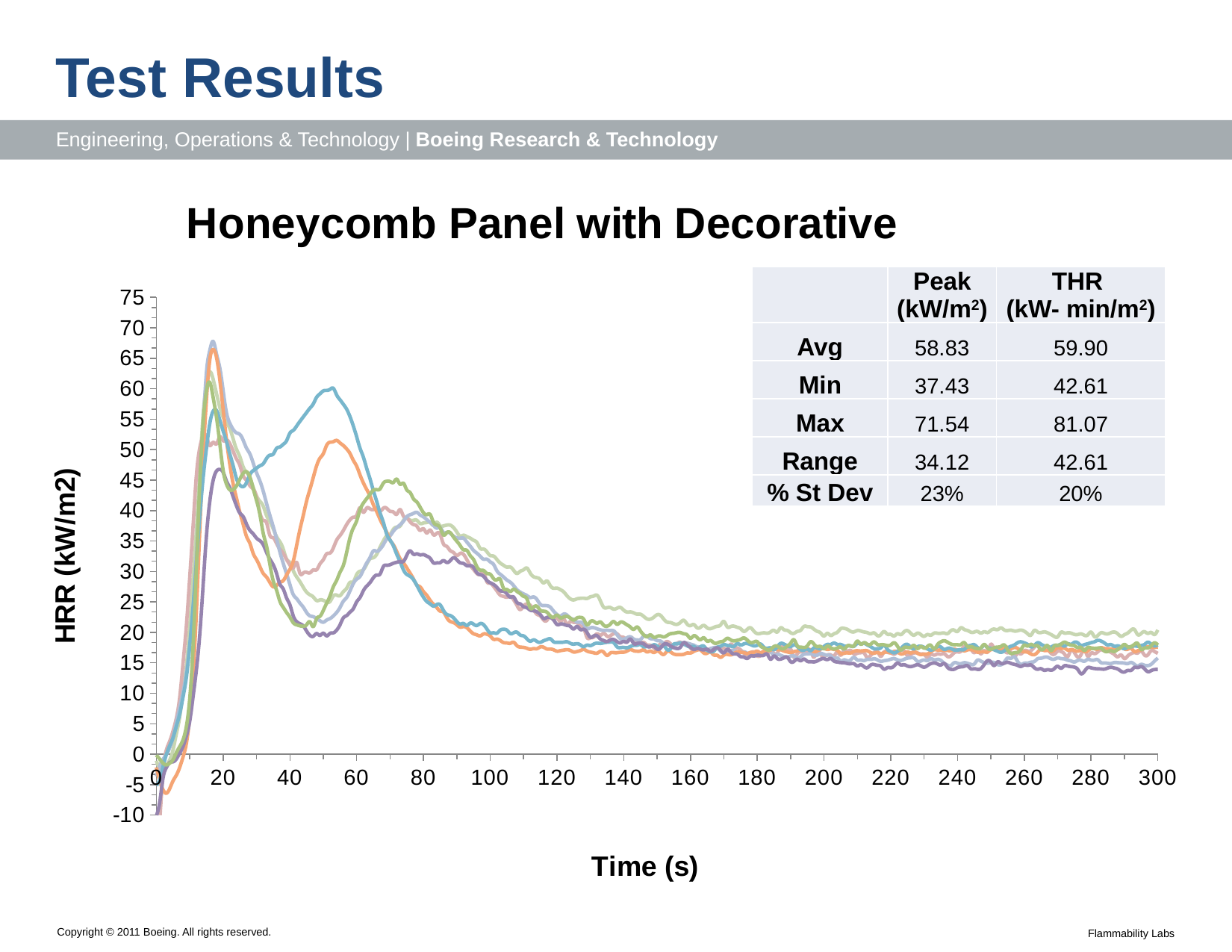
In the table on the slide, what is the Max THR (kW- min/m²) value? 81.07 In the table on the slide, what is the Avg Peak (kW/m²) value? 58.83 What is the label of the vertical axis of the chart? HRR (kW/m2) In the table on the slide, what is the % St Dev for Peak (kW/m²)? 23% What is the maximum value shown on the x axis of the chart? 300 In the table on the slide, which is larger, the Min Peak (kW/m²) or the Min THR (kW- min/m²)? Min THR (kW- min/m²) What kind of chart is shown on the slide? line chart At 300 s, are all the lines in the chart greater or less than 25? less What is the title of the chart? Honeycomb Panel with Decorative Is the highest peak reached by any line in the chart greater or less than 60? greater Do the HRR values rise or fall along the x axis between 100 s and 300 s? fall At 200 s, are the lines in the chart greater or less than 30? less